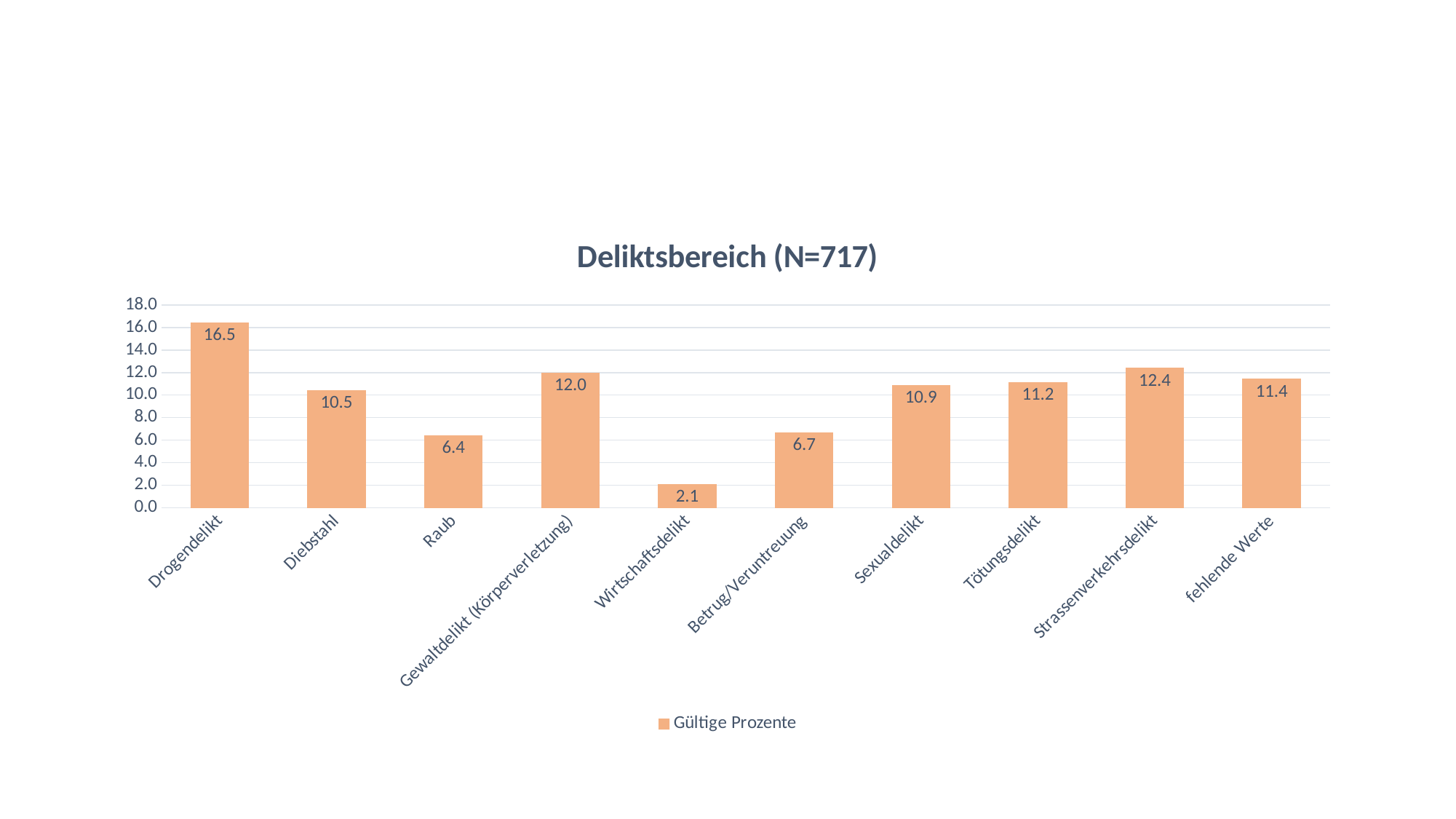
What is the value for Drogendelikt? 16.5 Which category has the lowest value? Wirtschaftsdelikt Which category has the highest value? Drogendelikt Is the value for Gewaltdelikt (Körperverletzung) greater or less than 10.0? greater What is the title of the chart? Deliktsbereich (N=717) How many categories are shown on the x axis? 10 What kind of chart is shown? bar chart What is the value for Wirtschaftsdelikt? 2.1 Which is larger, the value for Raub or the value for Betrug/Veruntreuung? Betrug/Veruntreuung What is the difference between the values for Drogendelikt and Diebstahl? 6.0 What is the value for Strassenverkehrsdelikt? 12.4 How many series does the legend list? 1